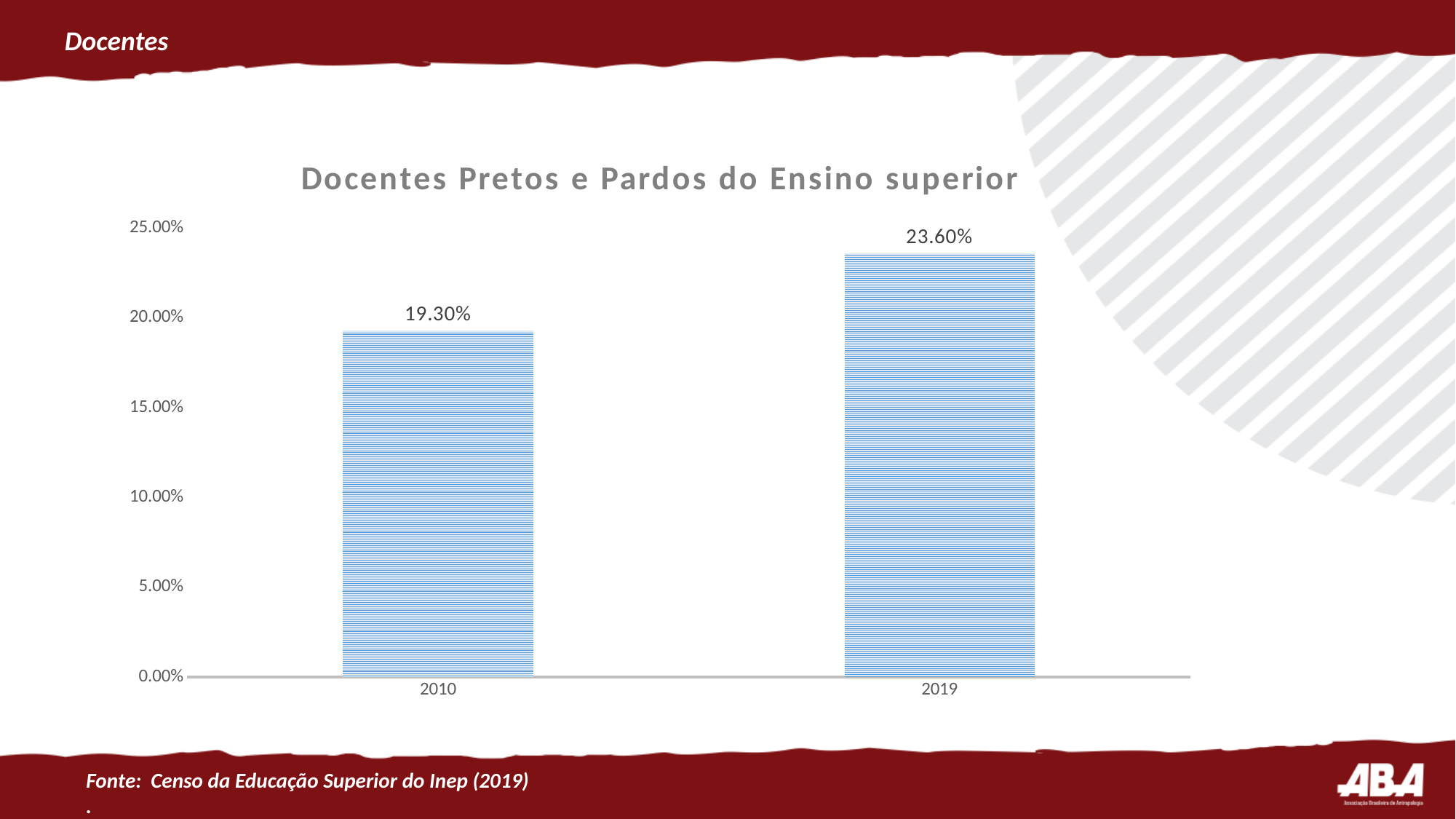
What is the title of the chart? Docentes Pretos e Pardos do Ensino superior How many categories are shown on the x axis? 2 Which is larger, the value for 2010 or the value for 2019? 2019 What is the difference between the values for 2019 and 2010? 4.30% Is the value for 2010 greater or less than 20.00%? less What kind of chart is shown? bar chart Is the value for 2019 greater or less than 20.00%? greater Which year has the lowest value? 2010 Do the values rise or fall from 2010 to 2019? rise Which year has the highest value? 2019 What is the value for 2010? 19.30% What is the value for 2019? 23.60%